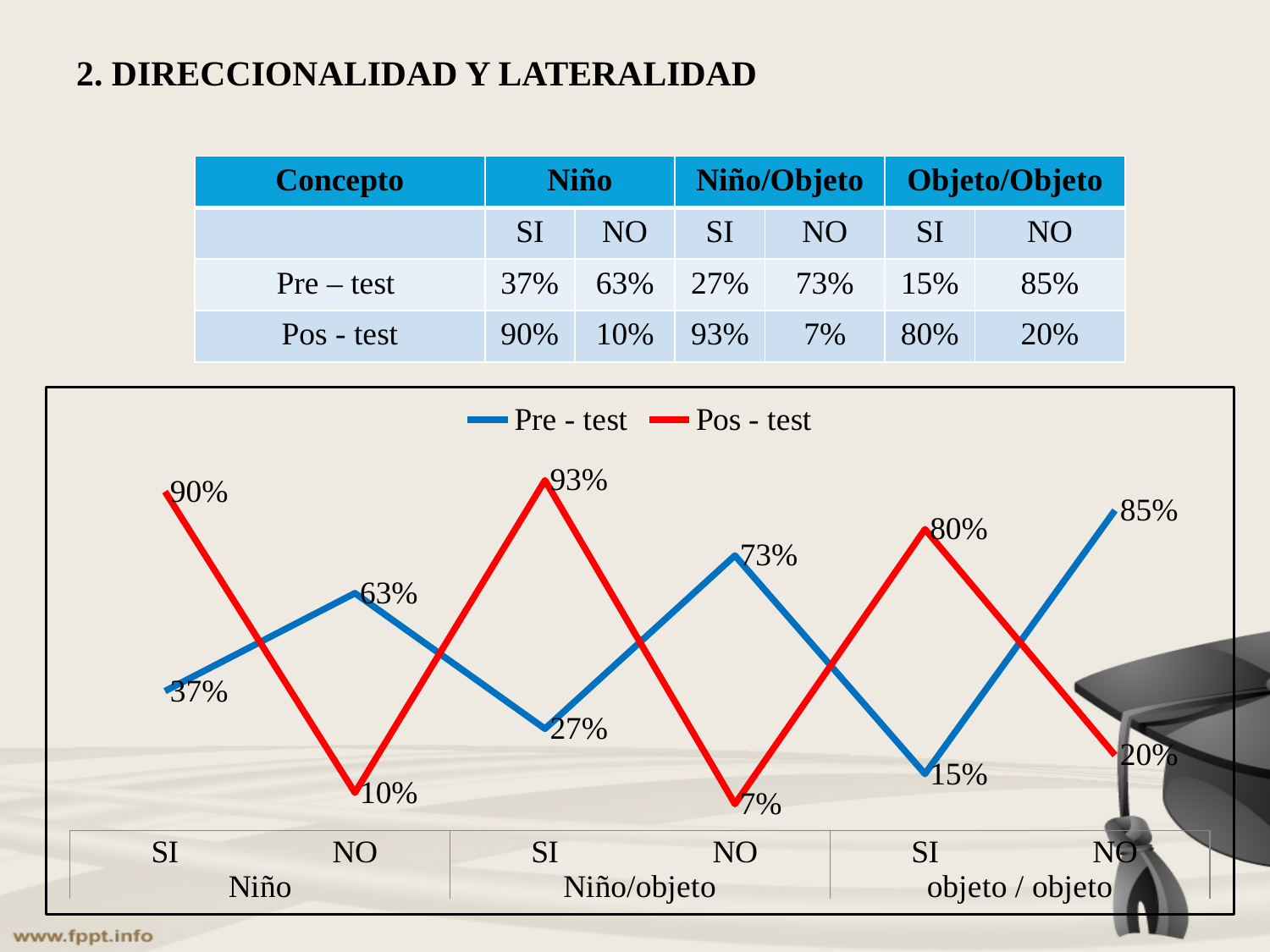
How many series does the chart legend list? 2 What is the difference between the Pos - test and Pre - test values for Niño SI? 53% What is the Pre - test value for Niño/objeto NO? 73% Which category has the highest Pre - test value? objeto / objeto NO What is the Pos - test value for Niño SI? 90% What is the Pos - test value for objeto / objeto SI? 80% What is the Pre - test value for objeto / objeto SI? 15% Which category has the highest Pos - test value? Niño/objeto SI What kind of chart is shown on the slide? line chart Which is larger for Niño NO, the Pre - test value or the Pos - test value? Pre - test How many categories are plotted along the x axis? 6 Which category has the lowest Pos - test value? Niño/objeto NO